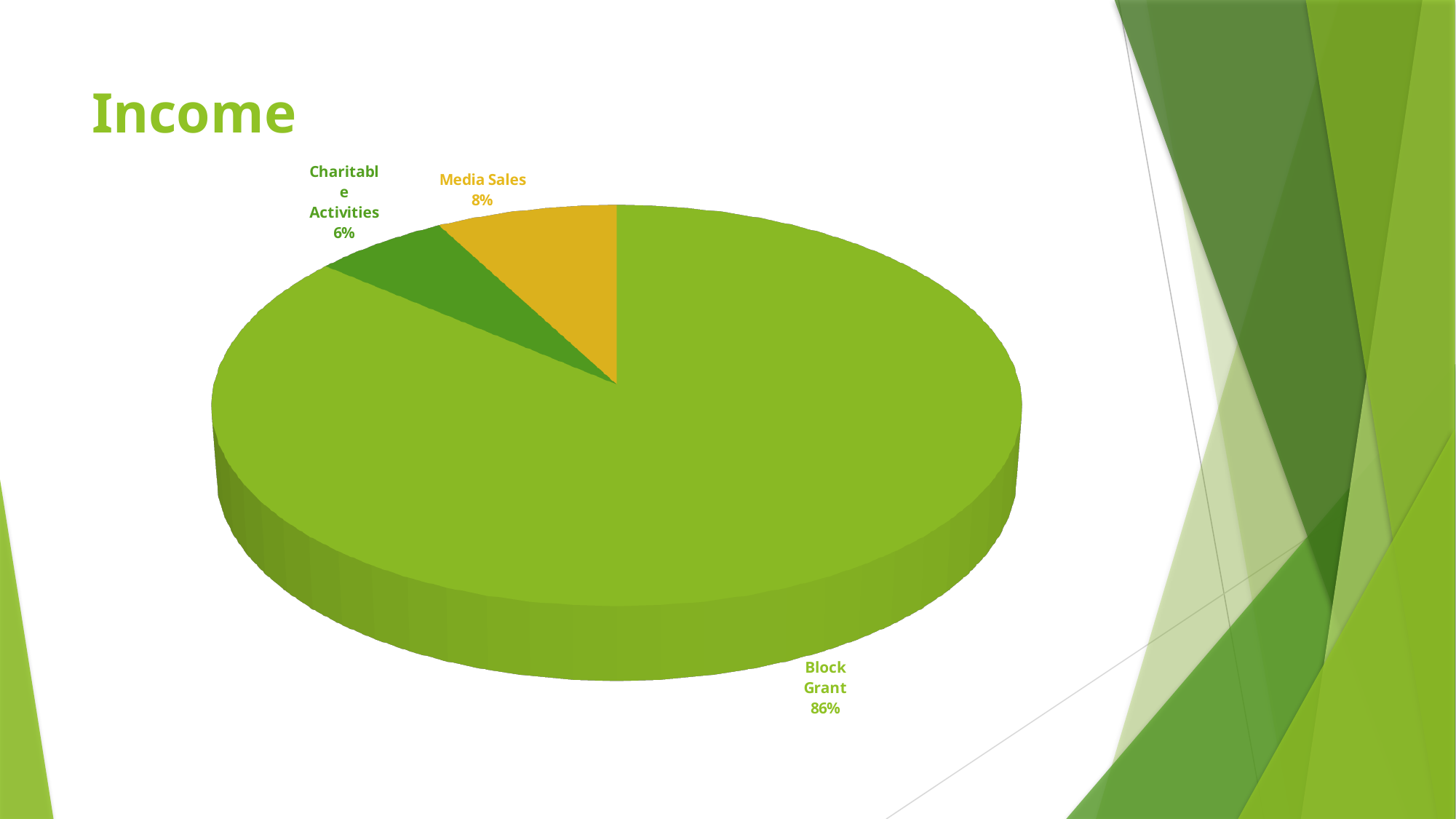
What is the title of the slide? Income What kind of chart is shown on the slide? Pie chart What share of income does Block Grant account for? 86% Which income source has the smallest share? Charitable Activities Which is larger, the Media Sales share or the Charitable Activities share? Media Sales How many slices does the pie chart have? 3 Which income source has the largest share? Block Grant What colour is the Media Sales slice? Yellow What share of income comes from Media Sales? 8% What is the difference in percentage points between Block Grant and Media Sales? 78 What share of income comes from Charitable Activities? 6% What is the difference in percentage points between Media Sales and Charitable Activities? 2